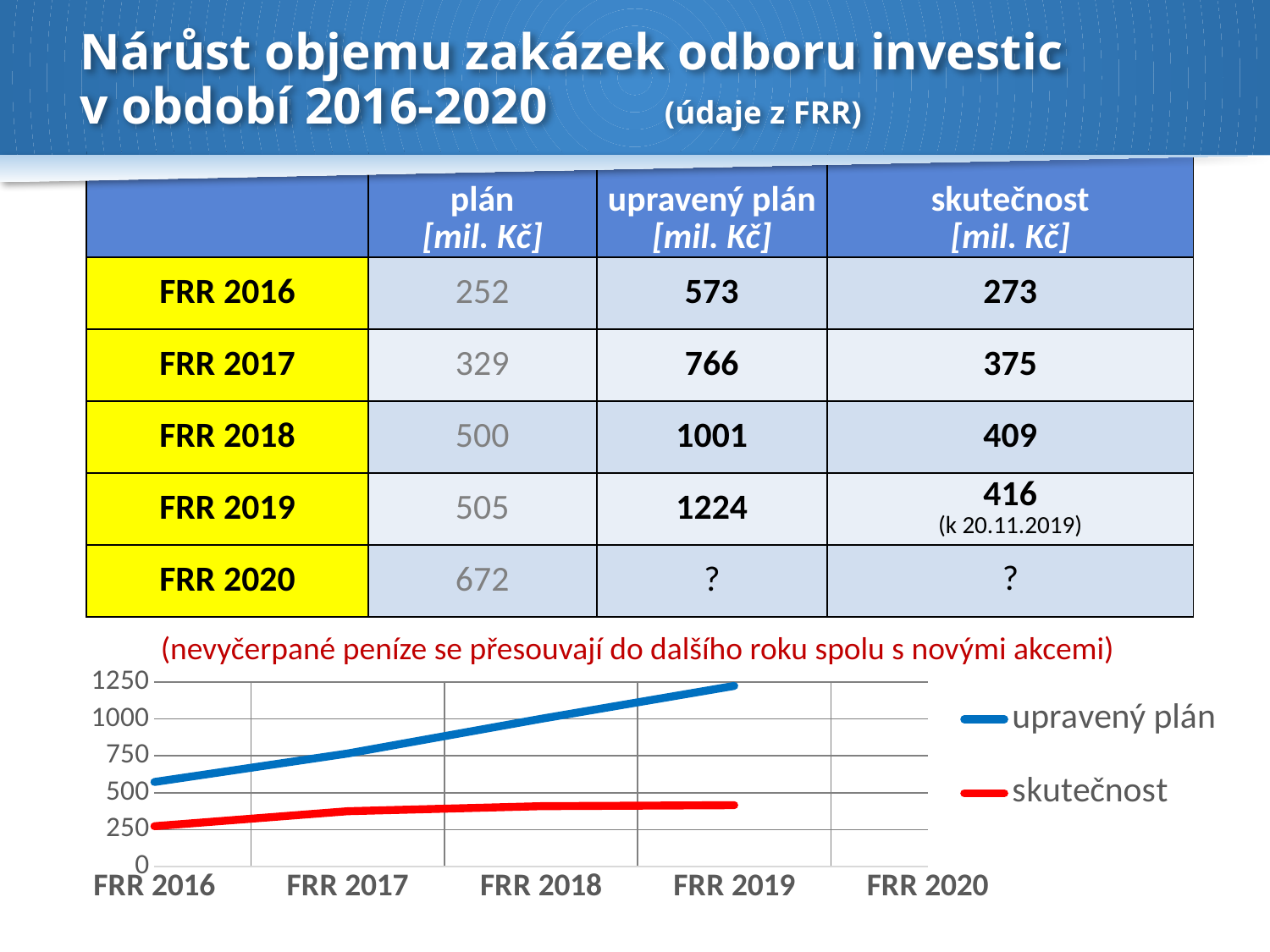
What kind of chart is shown at the bottom of the slide? line chart Does the 'upravený plán' line rise or fall from FRR 2016 to FRR 2019? rise What is the difference between 'upravený plán' and 'skutečnost' for FRR 2019 in mil. Kč? 808 For FRR 2018, which series has the larger value, 'upravený plán' or 'skutečnost'? upravený plán How many series does the chart's legend list? 2 What is the 'upravený plán' value for FRR 2019 in mil. Kč? 1224 At which category is the 'skutečnost' line at its lowest? FRR 2016 At which category does the 'upravený plán' line reach its highest value? FRR 2019 What colour is the 'skutečnost' line in the chart? red Is the 'upravený plán' value for FRR 2019 greater or less than 1000? greater How many categories are shown on the chart's x axis? 5 Is the 'skutečnost' value for FRR 2016 greater or less than 500? less